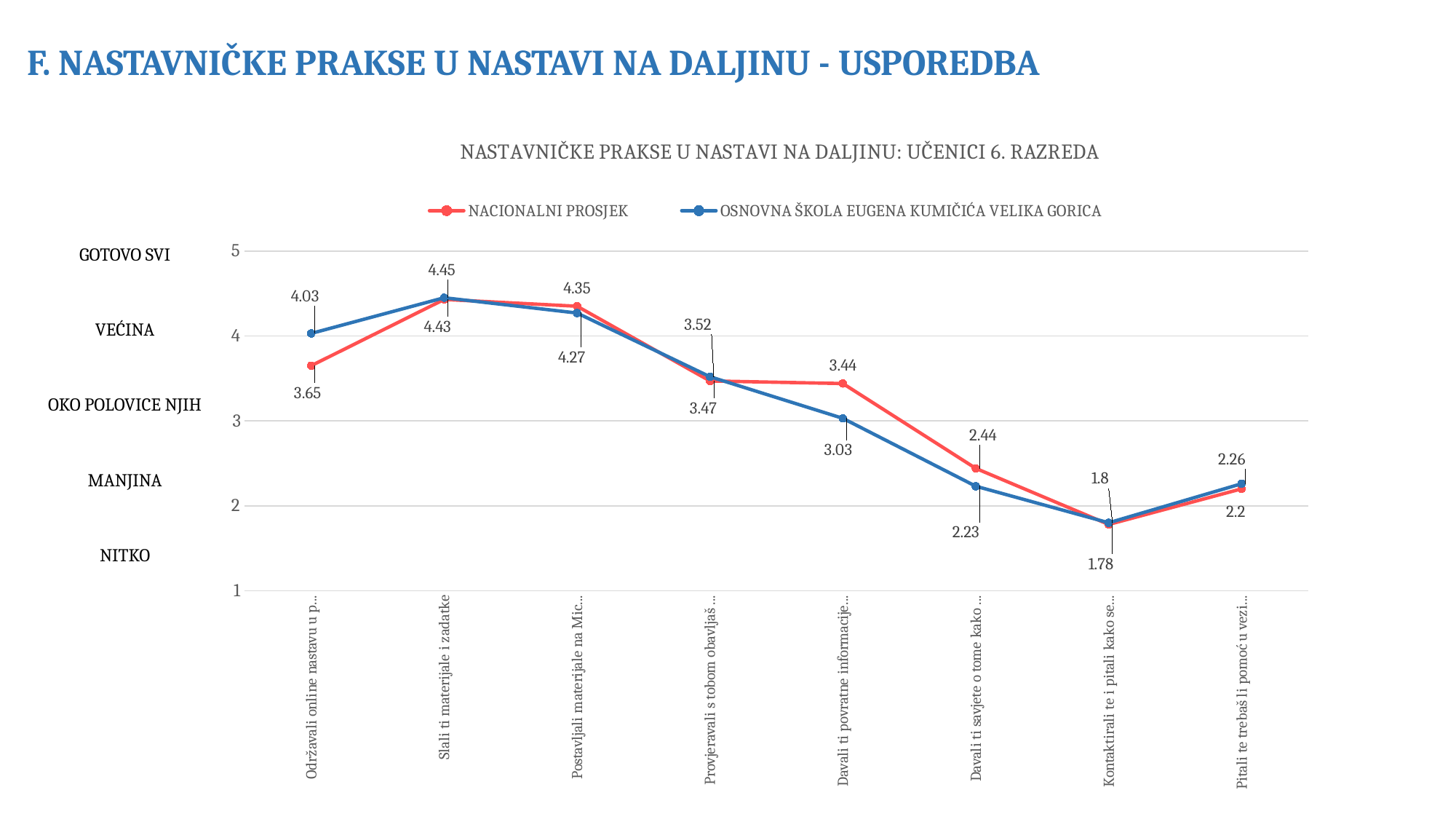
For the first category (Održavali online nastavu u p...), which series has the higher value? OSNOVNA ŠKOLA EUGENA KUMIČIĆA VELIKA GORICA How many series does the legend list? 2 Do the NACIONALNI PROSJEK values rise or fall from the second category to the seventh category? fall For the first category (Održavali online nastavu u p...), what is the difference between the OSNOVNA ŠKOLA EUGENA KUMIČIĆA VELIKA GORICA value and the NACIONALNI PROSJEK value? 0.38 What kind of chart is shown on the slide? line chart What is the title of the chart? NASTAVNIČKE PRAKSE U NASTAVI NA DALJINU: UČENICI 6. RAZREDA What is the lowest value plotted for NACIONALNI PROSJEK? 1.78 Which category has the highest value for OSNOVNA ŠKOLA EUGENA KUMIČIĆA VELIKA GORICA? Slali ti materijale i zadatke What is the value for OSNOVNA ŠKOLA EUGENA KUMIČIĆA VELIKA GORICA for 'Slali ti materijale i zadatke'? 4.45 For the category beginning 'Davali ti povratne informacije', what is the difference between the NACIONALNI PROSJEK value and the OSNOVNA ŠKOLA EUGENA KUMIČIĆA VELIKA GORICA value? 0.41 How many categories are plotted along the x axis? 8 What is the NACIONALNI PROSJEK value for 'Slali ti materijale i zadatke'? 4.43